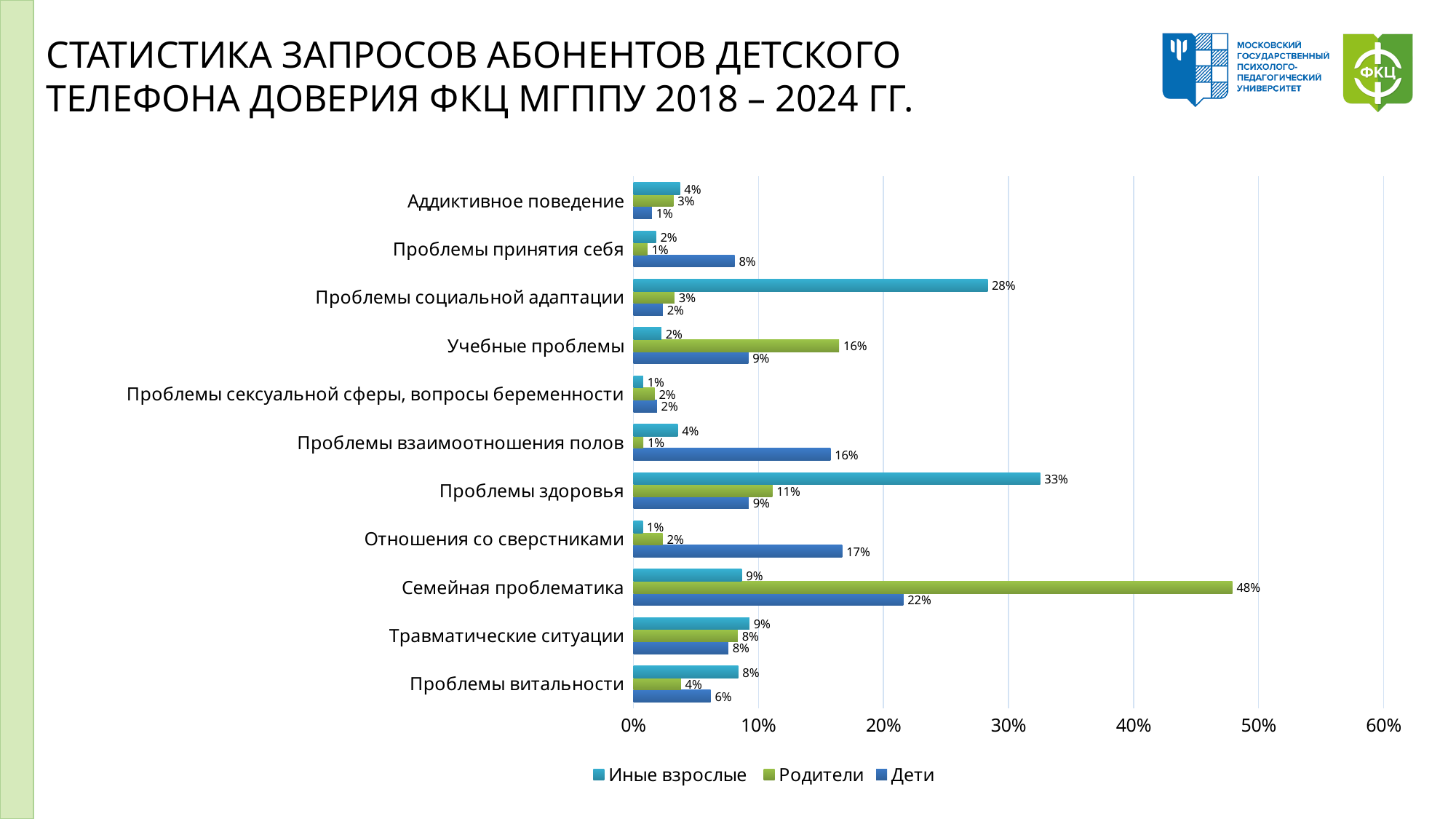
Which category has the highest value for the Дети series? Семейная проблематика What is the value for Дети in the category Отношения со сверстниками? 17% In the category Учебные проблемы, which series has the larger value: Родители or Дети? Родители What is the difference between the Иные взрослые and Родители values in the category Проблемы социальной адаптации? 25% What is the value for Иные взрослые in the category Проблемы здоровья? 33% What is the difference between the Родители and Дети values in the category Семейная проблематика? 26% What is the value for Родители in the category Семейная проблематика? 48% How many categories are shown on the chart? 11 How many series does the legend list? 3 Which series is shown in green in the legend? Родители What type of chart is shown on the slide? Bar chart Which category has the highest value for the Иные взрослые series? Проблемы здоровья